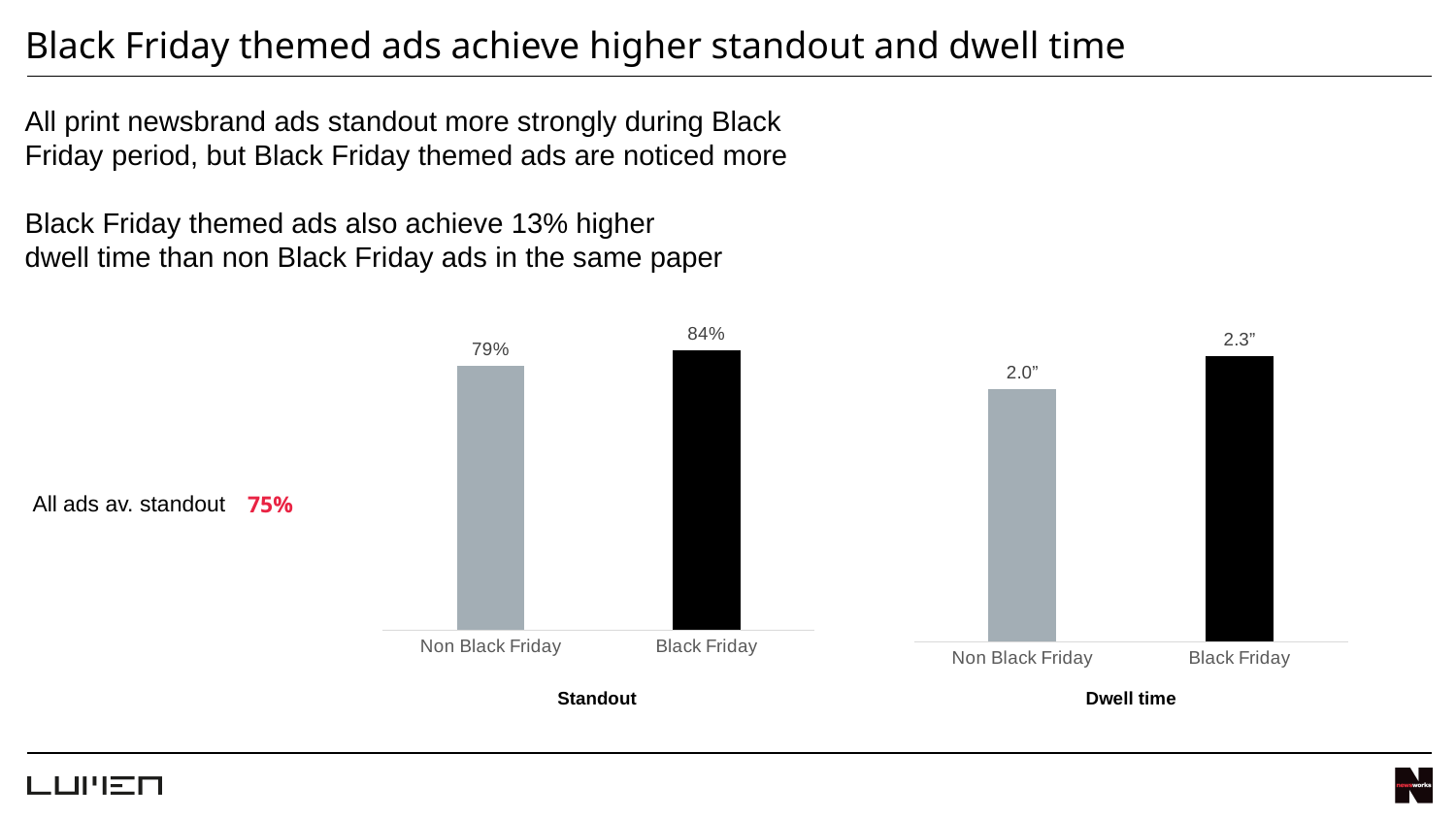
In the Dwell time chart, what is the value for Non Black Friday? 2.0" In the Standout chart, what is the value for Black Friday? 84% In the Dwell time chart, which is larger: Black Friday or Non Black Friday? Black Friday In the Dwell time chart, what is the value for Black Friday? 2.3" In the Standout chart, what is the difference between the Black Friday and Non Black Friday values? 5% In the Standout chart, what is the value for Non Black Friday? 79% What kind of chart is the Dwell time chart? Bar chart In the Dwell time chart, which category has the lowest value? Non Black Friday In the Dwell time chart, what is the difference between the Black Friday and Non Black Friday values? 0.3" What is the title of the chart on the left of the slide? Standout How many categories does the Standout chart show? 2 In the Standout chart, which category has the highest value? Black Friday